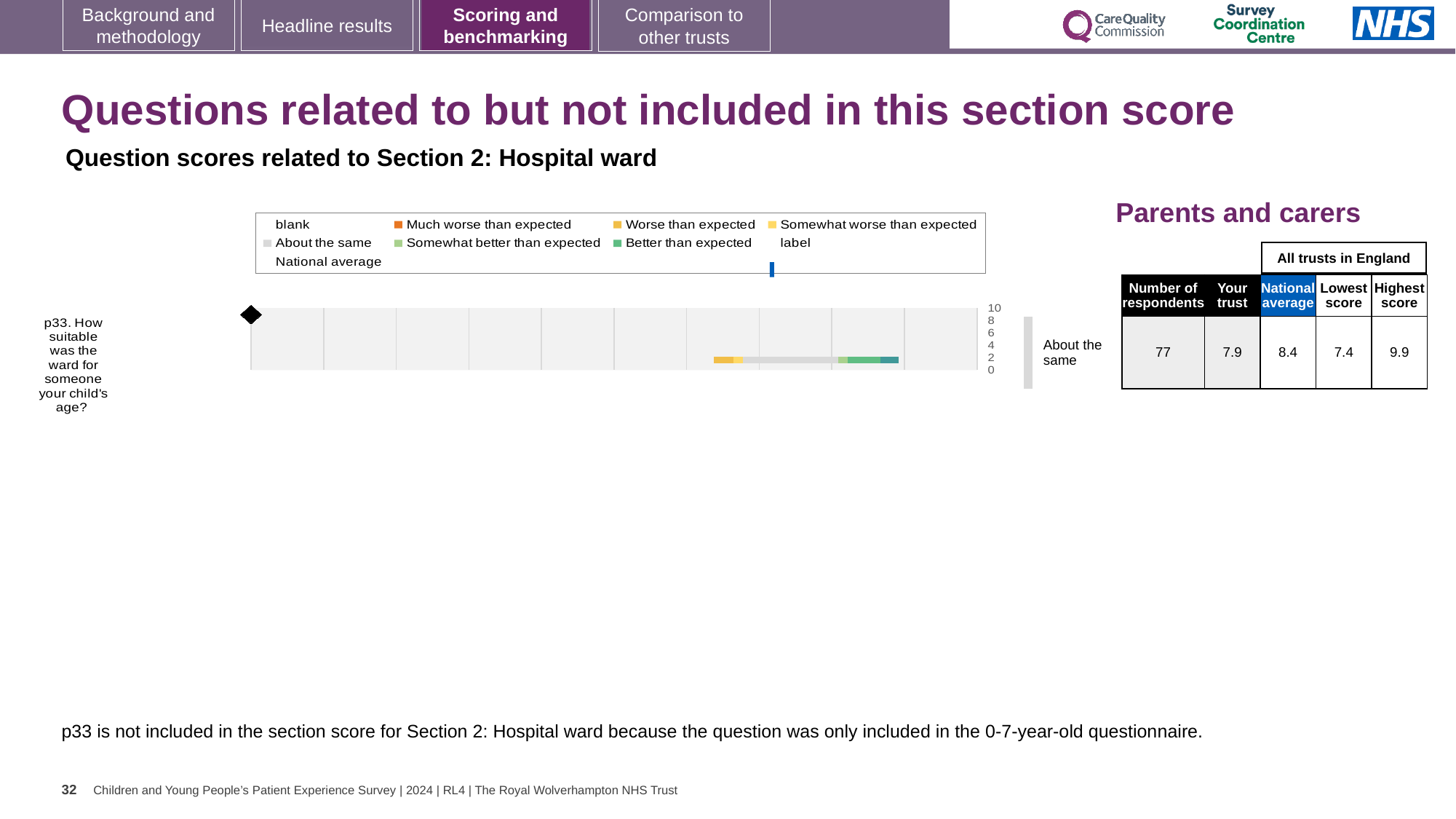
For question p33, which is larger: the Your trust score or the National average? National average In the table next to the chart, what is the Lowest score among all trusts in England for question p33? 7.4 How many questions are plotted in the chart on the slide? 1 In the table next to the chart, what is the score for Your trust for question p33? 7.9 What benchmark category is shown next to the chart for question p33? About the same In the table next to the chart, how many respondents answered question p33? 77 For question p33, what is the difference between the Highest score and the Lowest score in the table? 2.5 In the table next to the chart, what is the Highest score among all trusts in England for question p33? 9.9 What kind of chart is shown on the slide for question p33? bar chart What is the highest value shown on the chart's axis? 10 In the table next to the chart, what is the National average for question p33? 8.4 Which question is plotted in the chart on the slide? p33. How suitable was the ward for someone your child's age?